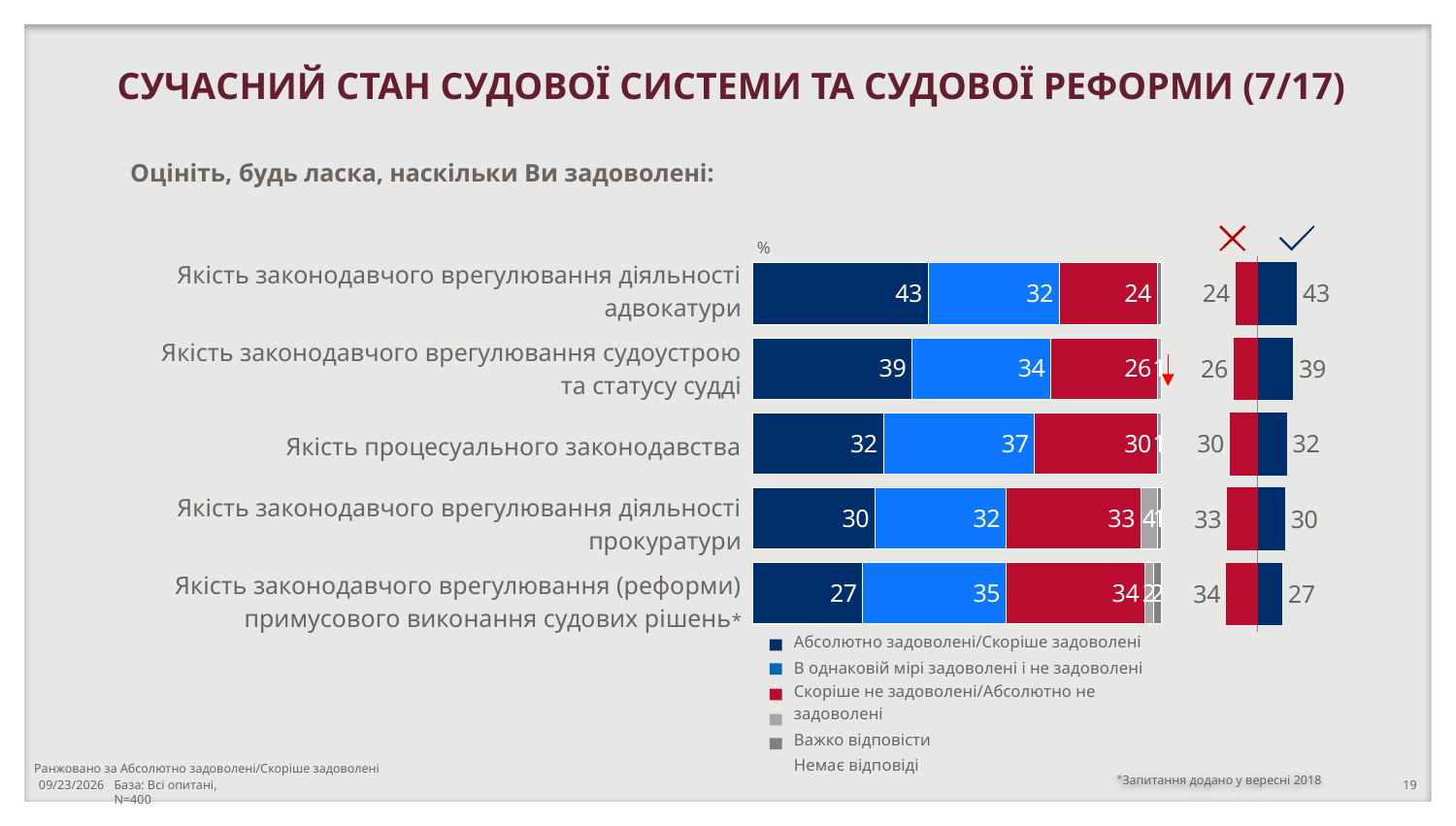
What kind of chart is shown on the slide? Stacked bar chart What is the value for "Важко відповісти" for "Якість законодавчого врегулювання діяльності прокуратури"? 4 What is the value for "Скоріше не задоволені/Абсолютно не задоволені" for "Якість законодавчого врегулювання діяльності адвокатури"? 24 Which has a larger "В однаковій мірі задоволені і не задоволені" value: "Якість процесуального законодавства" or "Якість законодавчого врегулювання діяльності адвокатури"? Якість процесуального законодавства What colour represents "Скоріше не задоволені/Абсолютно не задоволені" in the chart? Red Which category has the highest value for "Абсолютно задоволені/Скоріше задоволені"? Якість законодавчого врегулювання діяльності адвокатури What is the value for "Абсолютно задоволені/Скоріше задоволені" for "Якість процесуального законодавства"? 32 How many series does the legend list? 5 How many categories are shown in the chart? 5 What is the difference between the "Абсолютно задоволені/Скоріше задоволені" values for "Якість законодавчого врегулювання діяльності адвокатури" and "Якість законодавчого врегулювання (реформи) примусового виконання судових рішень"? 16 Which category has the highest value for "Скоріше не задоволені/Абсолютно не задоволені"? Якість законодавчого врегулювання (реформи) примусового виконання судових рішень Which category has the lowest value for "Абсолютно задоволені/Скоріше задоволені"? Якість законодавчого врегулювання (реформи) примусового виконання судових рішень